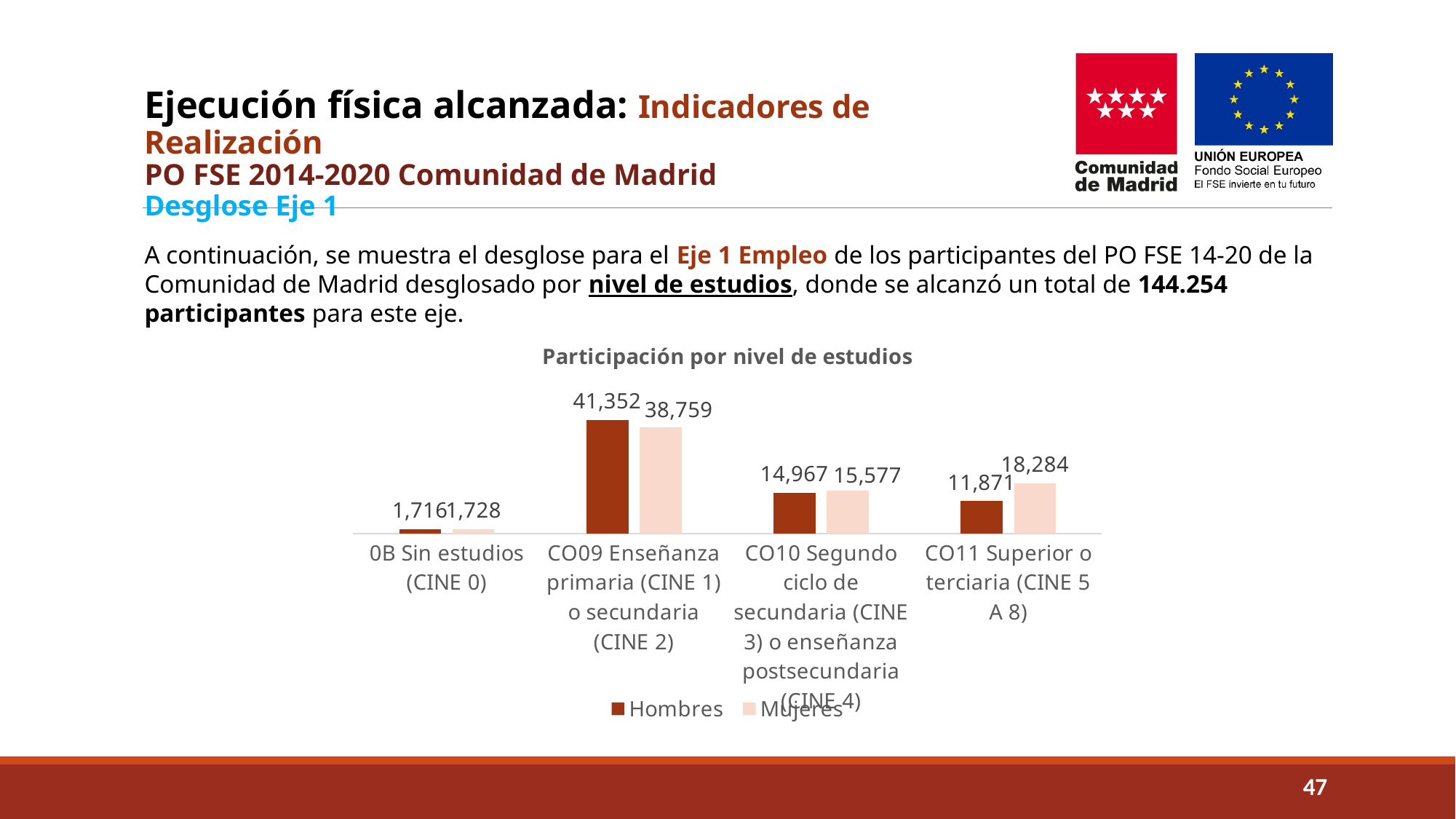
What is the difference between the Mujeres and Hombres values for CO11 Superior o terciaria (CINE 5 A 8)? 6,413 For CO11 Superior o terciaria (CINE 5 A 8), which series has the larger value, Hombres or Mujeres? Mujeres How many education-level categories are shown on the x axis? 4 What type of chart is shown on the slide? Bar chart What is the Hombres value for 0B Sin estudios (CINE 0)? 1,716 What is the difference between the Hombres and Mujeres values for CO09 Enseñanza primaria (CINE 1) o secundaria (CINE 2)? 2,593 How many series does the legend list? 2 What is the Mujeres value for CO10 Segundo ciclo de secundaria (CINE 3) o enseñanza postsecundaria (CINE 4)? 15,577 Which category has the lowest Mujeres value? 0B Sin estudios (CINE 0) Which category has the highest Hombres value? CO09 Enseñanza primaria (CINE 1) o secundaria (CINE 2) What is the Mujeres value for CO11 Superior o terciaria (CINE 5 A 8)? 18,284 What is the Hombres value for CO09 Enseñanza primaria (CINE 1) o secundaria (CINE 2)? 41,352